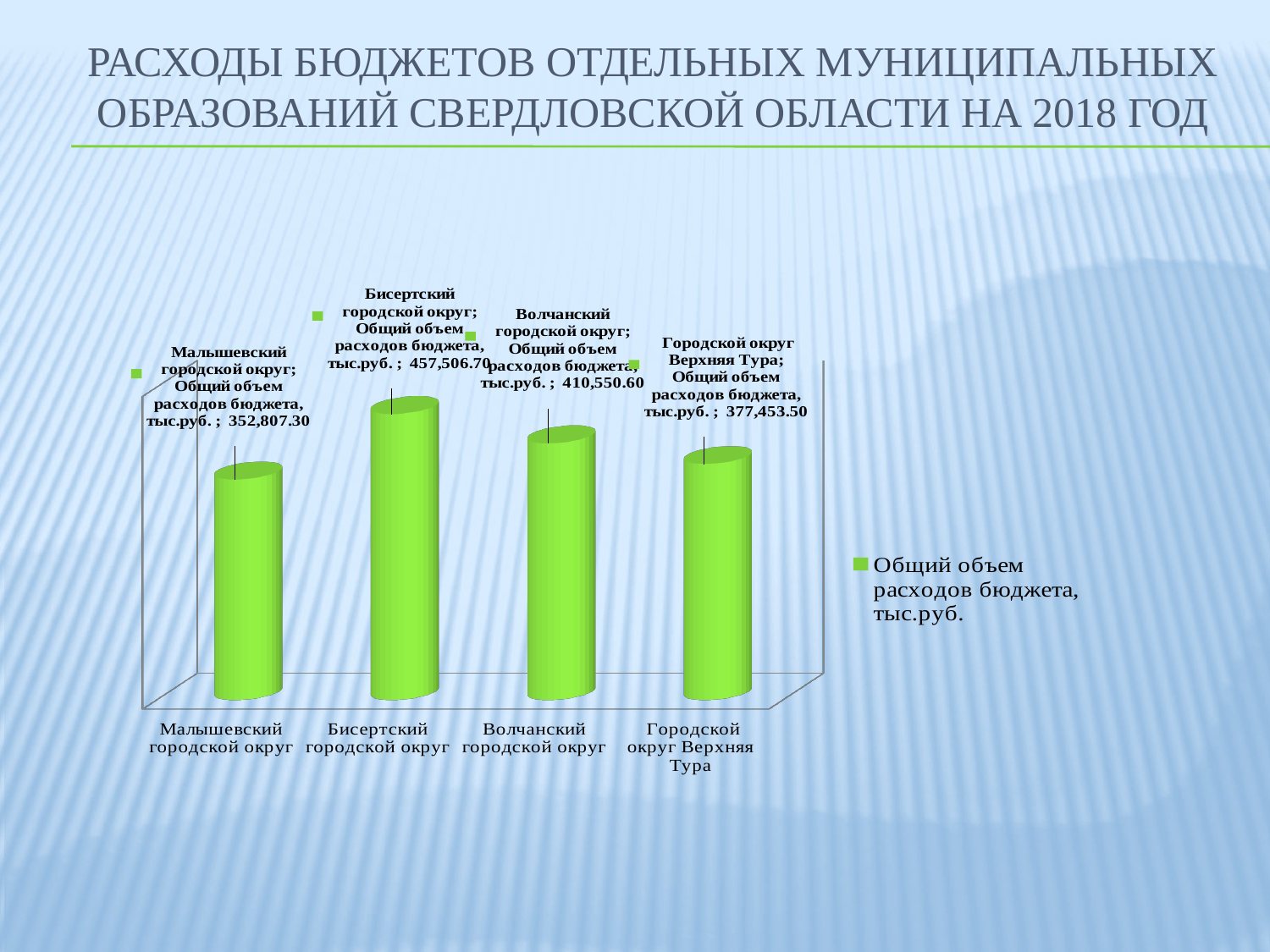
What kind of chart is shown on the slide? Bar chart Which municipality has the highest budget expenditure? Бисертский городской округ Which municipality has the lowest budget expenditure? Малышевский городской округ What is the value for Бисертский городской округ? 457,506.70 What is the value for Волчанский городской округ? 410,550.60 Which is larger: the value for Волчанский городской округ or Городской округ Верхняя Тура? Волчанский городской округ What is the value for Городской округ Верхняя Тура? 377,453.50 What is the difference between the values for Бисертский городской округ and Малышевский городской округ? 104,699.40 What is the value for Малышевский городской округ? 352,807.30 What is the difference between the values for Волчанский городской округ and Городской округ Верхняя Тура? 33,097.10 How many series does the legend list? 1 How many municipalities are shown in the chart? 4